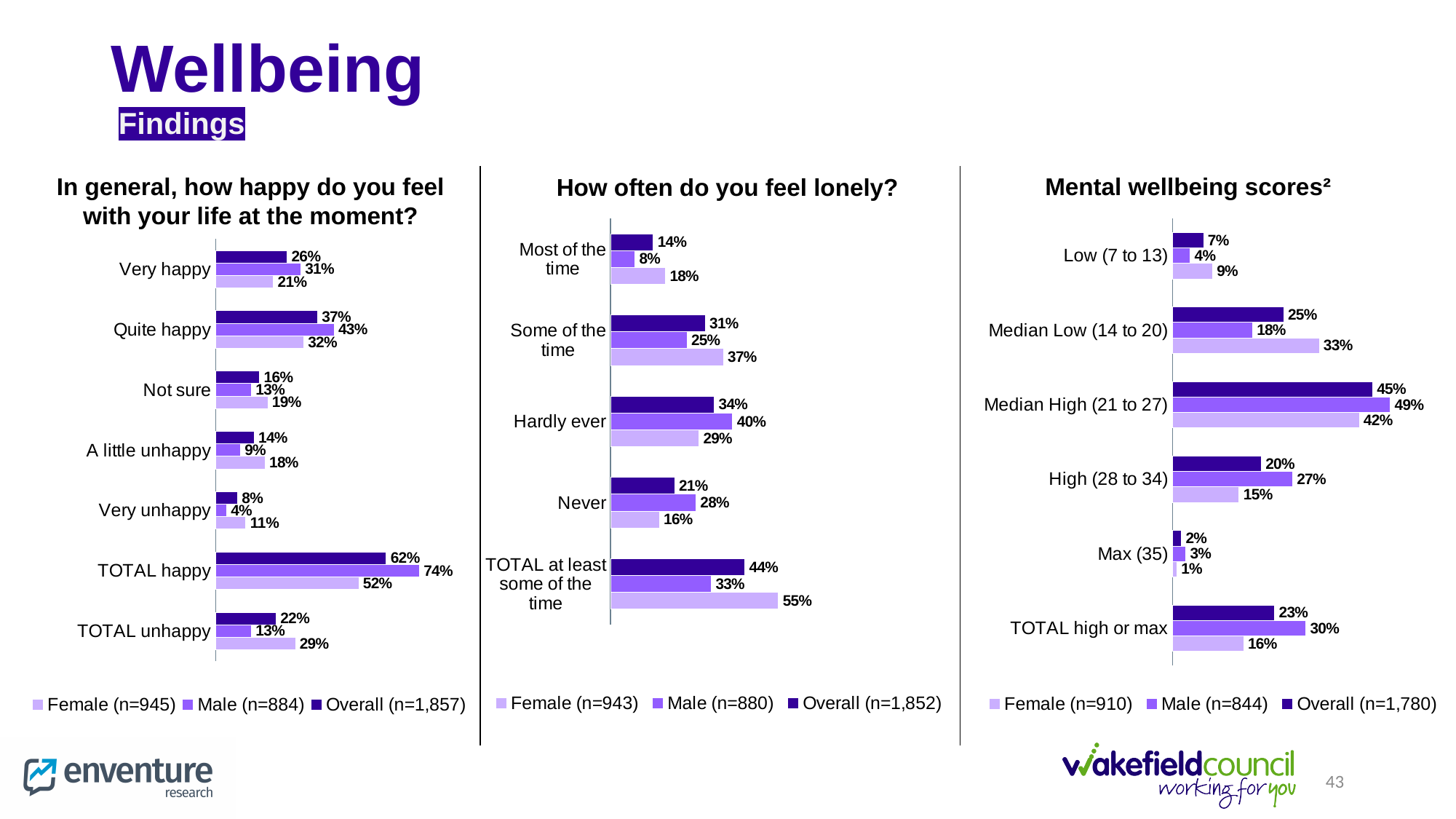
In the 'How often do you feel lonely?' chart, which category has the highest Female value? TOTAL at least some of the time In the 'Mental wellbeing scores' chart, which category has the lowest Female value? Max (35) In the 'How often do you feel lonely?' chart, what is the Overall value for Hardly ever? 34% In the 'In general, how happy do you feel with your life at the moment?' chart, what is the Male value for TOTAL happy? 74% In the 'In general, how happy do you feel with your life at the moment?' chart, what is the Female value for Very unhappy? 11% In the 'Mental wellbeing scores' chart, what is the difference between the Female and Male values for Median Low (14 to 20)? 15% In the 'In general, how happy do you feel with your life at the moment?' chart, what is the difference between the Male and Female values for TOTAL happy? 22% How many series does the legend of the 'Mental wellbeing scores' chart list? 3 What type of chart is the 'How often do you feel lonely?' chart? Bar chart In the 'How often do you feel lonely?' chart, how many categories are shown on the y axis? 5 In the 'How often do you feel lonely?' chart, which is larger for Never: the Male value or the Female value? Male In the 'Mental wellbeing scores' chart, what is the Male value for Median High (21 to 27)? 49%